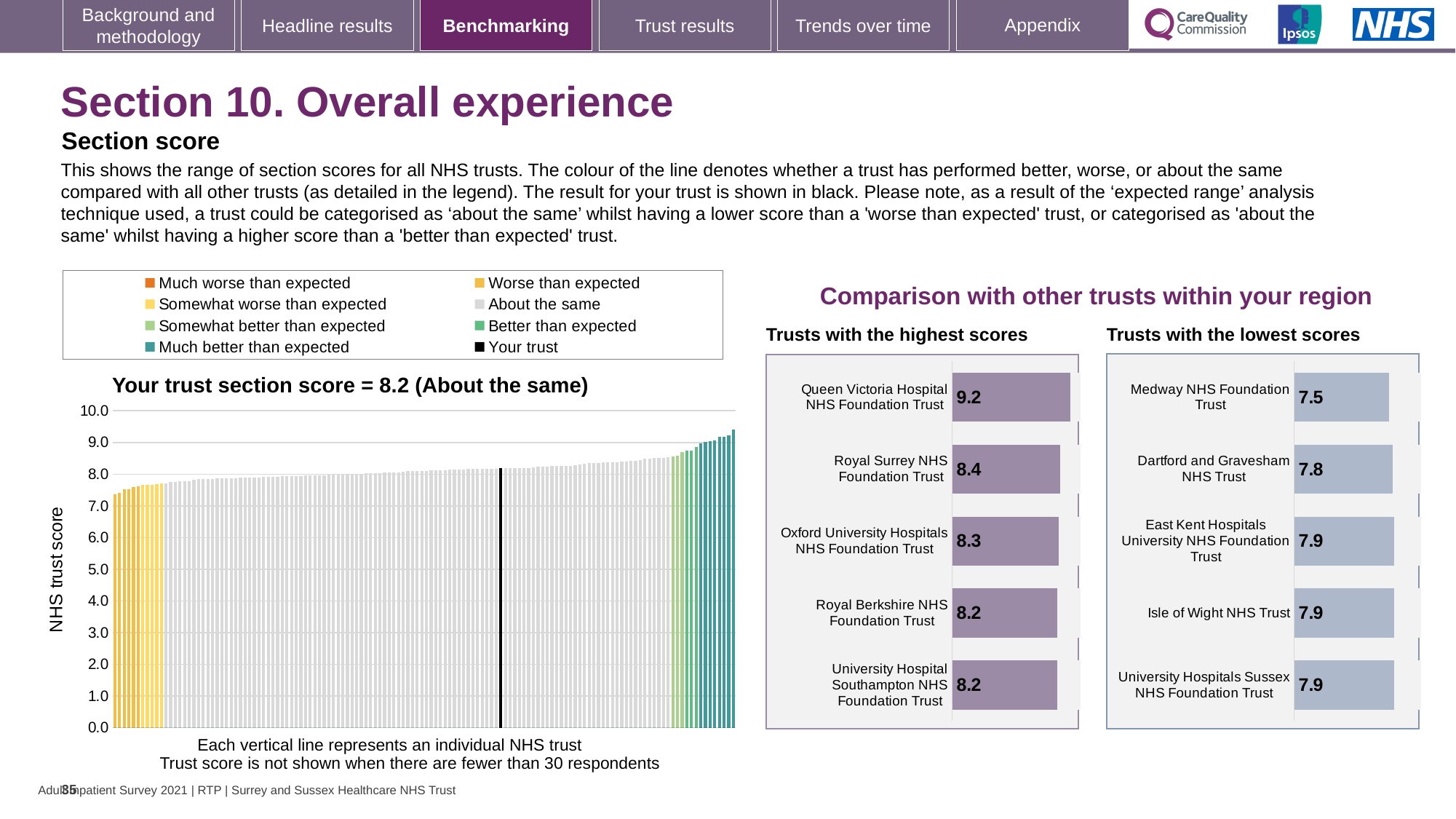
On the 'Trusts with the lowest scores' chart, what is the score for Medway NHS Foundation Trust? 7.5 On the 'Trusts with the highest scores' chart, how many trusts are shown? 5 On the 'Your trust section score' chart, what is the section score for your trust? 8.2 On the 'Your trust section score' chart, what category does your trust fall into according to the chart title? About the same On the 'Trusts with the lowest scores' chart, which has the larger score, Medway NHS Foundation Trust or Dartford and Gravesham NHS Trust? Dartford and Gravesham NHS Trust On the 'Trusts with the highest scores' chart, what is the difference between the scores of Queen Victoria Hospital NHS Foundation Trust and Royal Surrey NHS Foundation Trust? 0.8 On the 'Your trust section score' chart, do the trust scores rise or fall from left to right along the x axis? rise On the 'Trusts with the lowest scores' chart, which trust has the lowest score? Medway NHS Foundation Trust On the 'Your trust section score' chart, how many entries does the legend list? 8 On the 'Trusts with the highest scores' chart, which trust has the highest score? Queen Victoria Hospital NHS Foundation Trust On the 'Your trust section score' chart, what kind of chart is shown? bar chart On the 'Trusts with the highest scores' chart, what is the score for Queen Victoria Hospital NHS Foundation Trust? 9.2